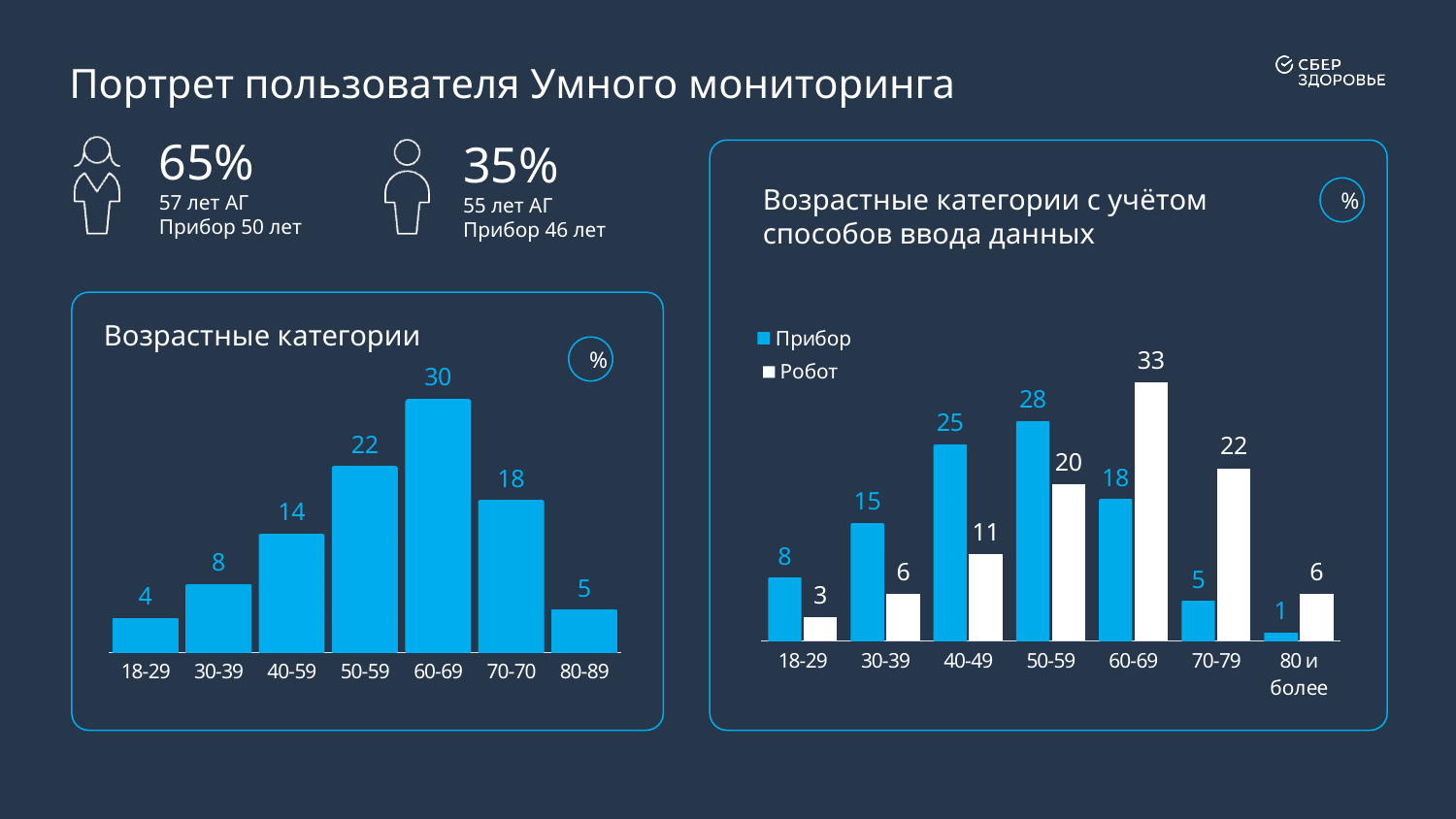
In the chart 'Возрастные категории с учётом способов ввода данных' on the right, which category has the lowest Прибор value? 80 и более In the chart 'Возрастные категории' on the left, which age category has the lowest value? 18-29 In the chart 'Возрастные категории' on the left, what is the difference between the values for 50-59 and 30-39? 14 In the chart 'Возрастные категории' on the left, what kind of chart is used? Bar chart In the chart 'Возрастные категории с учётом способов ввода данных' on the right, what is the difference between Робот and Прибор for the 60-69 category? 15 In the chart 'Возрастные категории с учётом способов ввода данных' on the right, what is the value of Робот for the 60-69 category? 33 In the chart 'Возрастные категории с учётом способов ввода данных' on the right, which is larger for the 70-79 category: Прибор or Робот? Робот In the chart 'Возрастные категории с учётом способов ввода данных' on the right, what is the value of Прибор for the 40-49 category? 25 In the chart 'Возрастные категории с учётом способов ввода данных' on the right, how many series does the legend list? 2 In the chart 'Возрастные категории' on the left, how many age categories are shown? 7 In the chart 'Возрастные категории с учётом способов ввода данных' on the right, which category has the highest Прибор value? 50-59 In the chart 'Возрастные категории' on the left, what is the value for the 60-69 category? 30